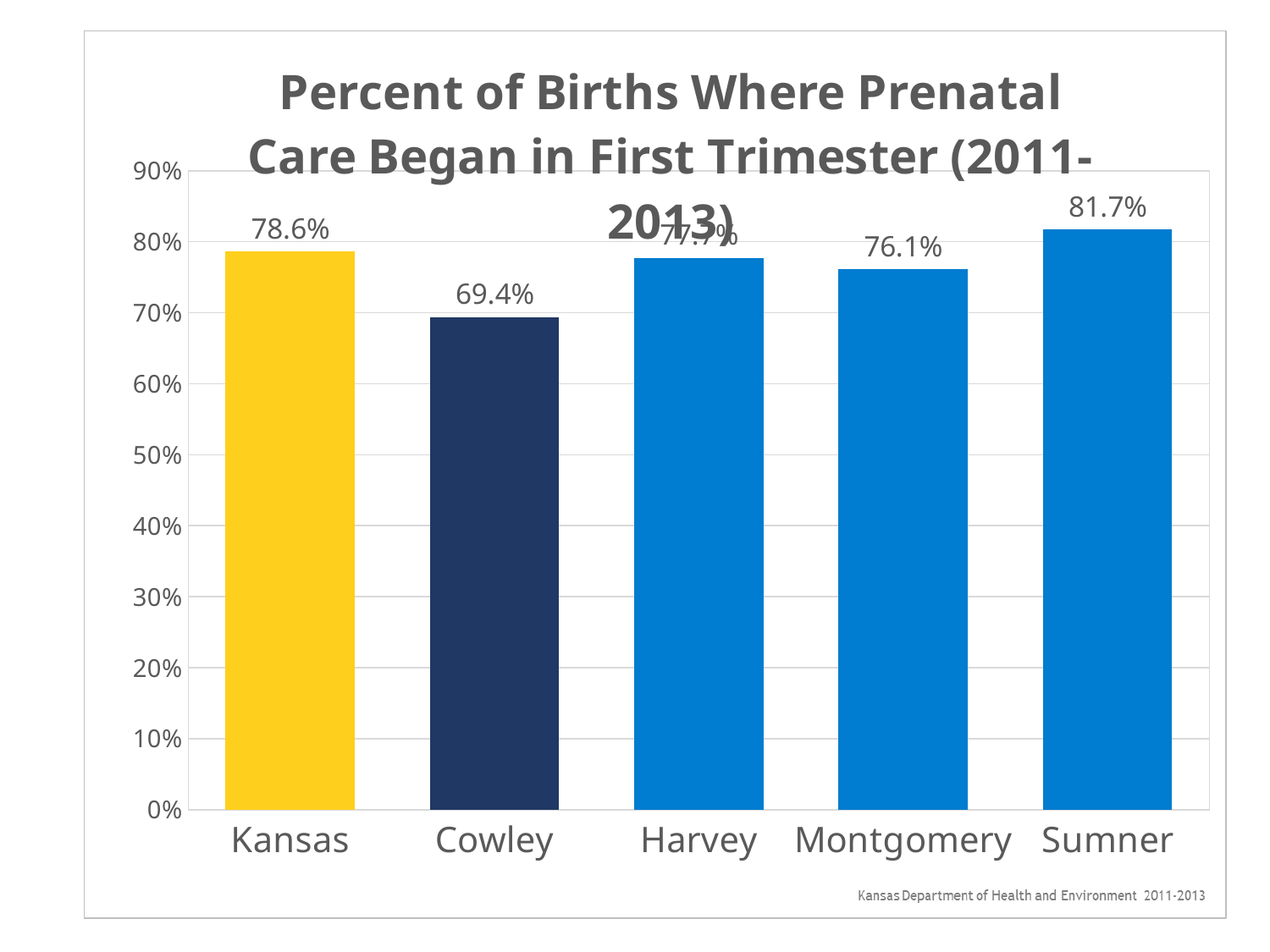
Which category has the lowest value? Cowley What is the difference between the values for Sumner and Cowley? 12.3% How many categories are shown on the x axis? 5 What is the value for Cowley? 69.4% Which is larger, the value for Kansas or the value for Cowley? Kansas Is the value for Harvey greater or less than 70%? greater What is the value for Kansas? 78.6% What is the difference between the values for Kansas and Montgomery? 2.5% Which category has the highest value? Sumner What is the value for Sumner? 81.7% What kind of chart is shown on the slide? bar chart What is the value for Montgomery? 76.1%